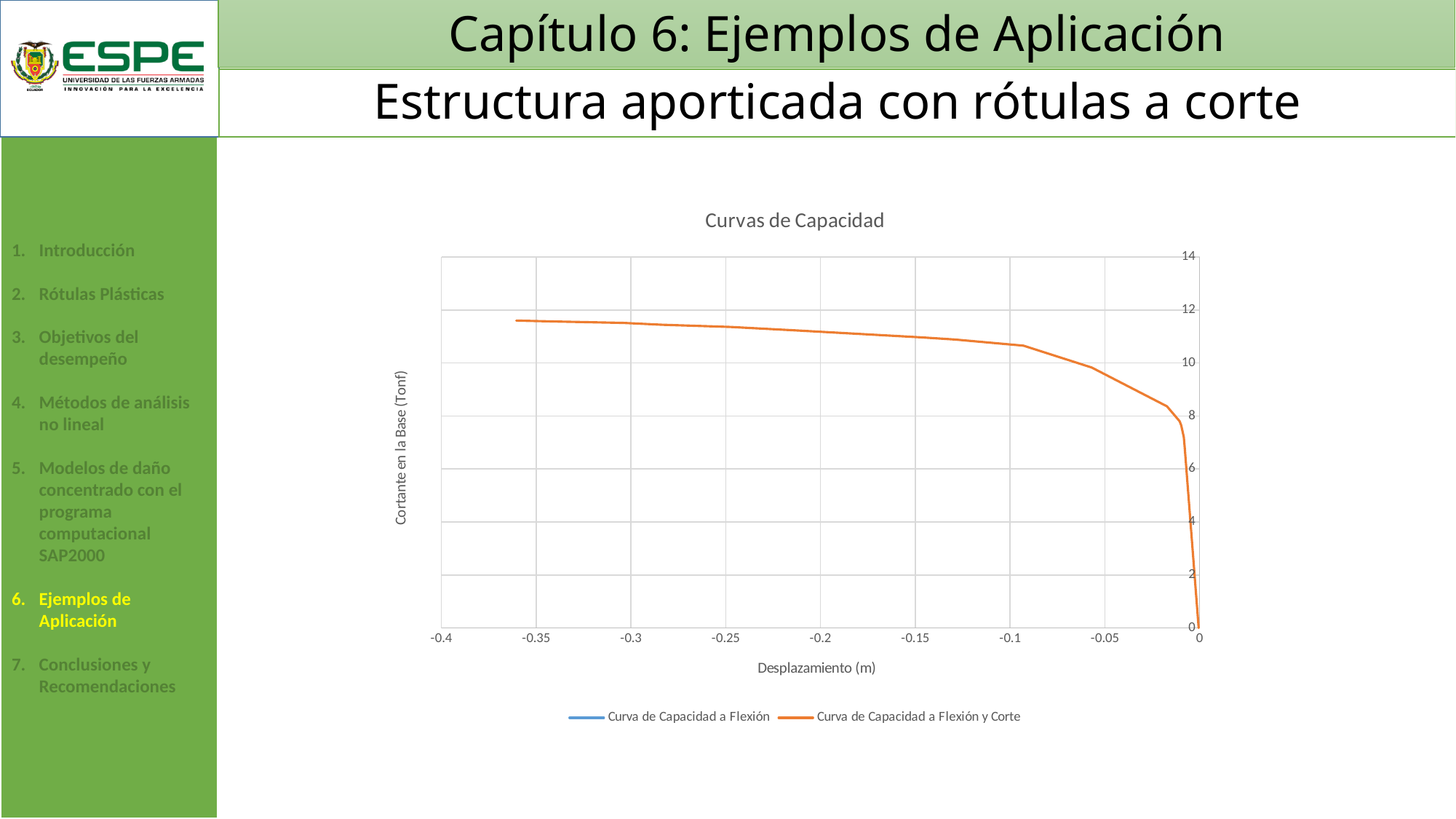
What is the title of the chart? Curvas de Capacidad What is the highest value shown on the y axis of the chart? 14 Is the value of the Curva de Capacidad a Flexión y Corte at a displacement of -0.1 m greater or less than 10? greater Does the Curva de Capacidad a Flexión y Corte rise or fall as the displacement moves from -0.35 m toward 0 m along the x axis? fall Is the value of the Curva de Capacidad a Flexión y Corte at a displacement of -0.3 m greater or less than 8? greater Which is larger for the Curva de Capacidad a Flexión y Corte: the value at a displacement of -0.3 m or the value at -0.05 m? -0.3 m What is the label of the x axis of the chart? Desplazamiento (m) What kind of chart is shown on the slide? Line chart Is the value of the Curva de Capacidad a Flexión y Corte at a displacement of -0.35 m greater or less than 12? less How many series does the chart legend list? 2